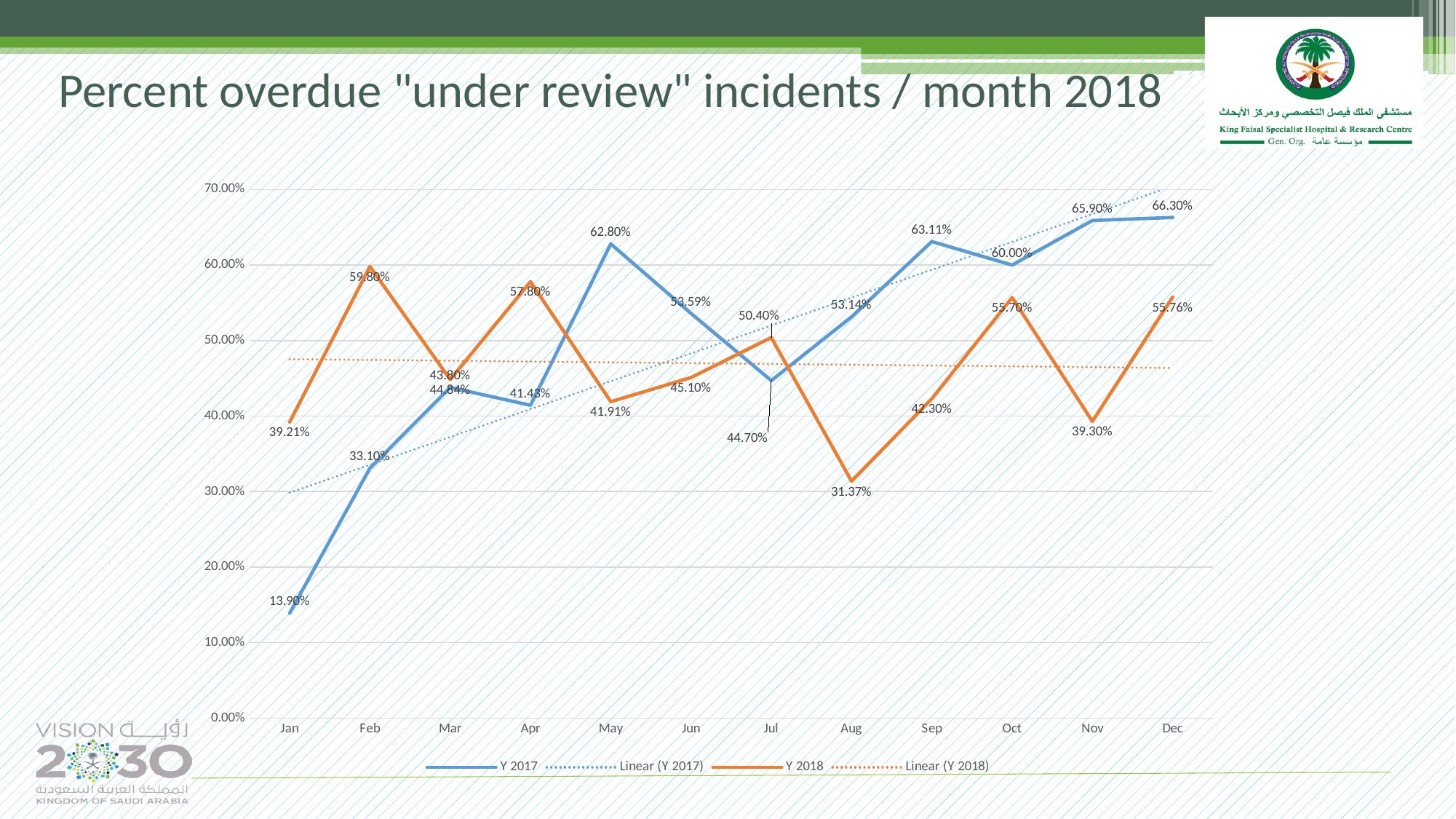
Which month has the highest Y 2017 value? Dec What is the Y 2018 value for Feb? 59.80% Is the Y 2017 value for May greater or less than 60.00%? greater What kind of chart is shown on the slide? Line chart Which month has the lowest Y 2018 value? Aug How many entries does the legend list? 4 What is the difference between the Y 2018 and Y 2017 values for Jan? 25.31 percentage points Which month has the lowest Y 2017 value? Jan Which is larger in Dec, the Y 2017 value or the Y 2018 value? Y 2017 What is the Y 2017 value for Jan? 13.90% What is the Y 2018 value for Aug? 31.37% How many months are plotted on the x axis? 12